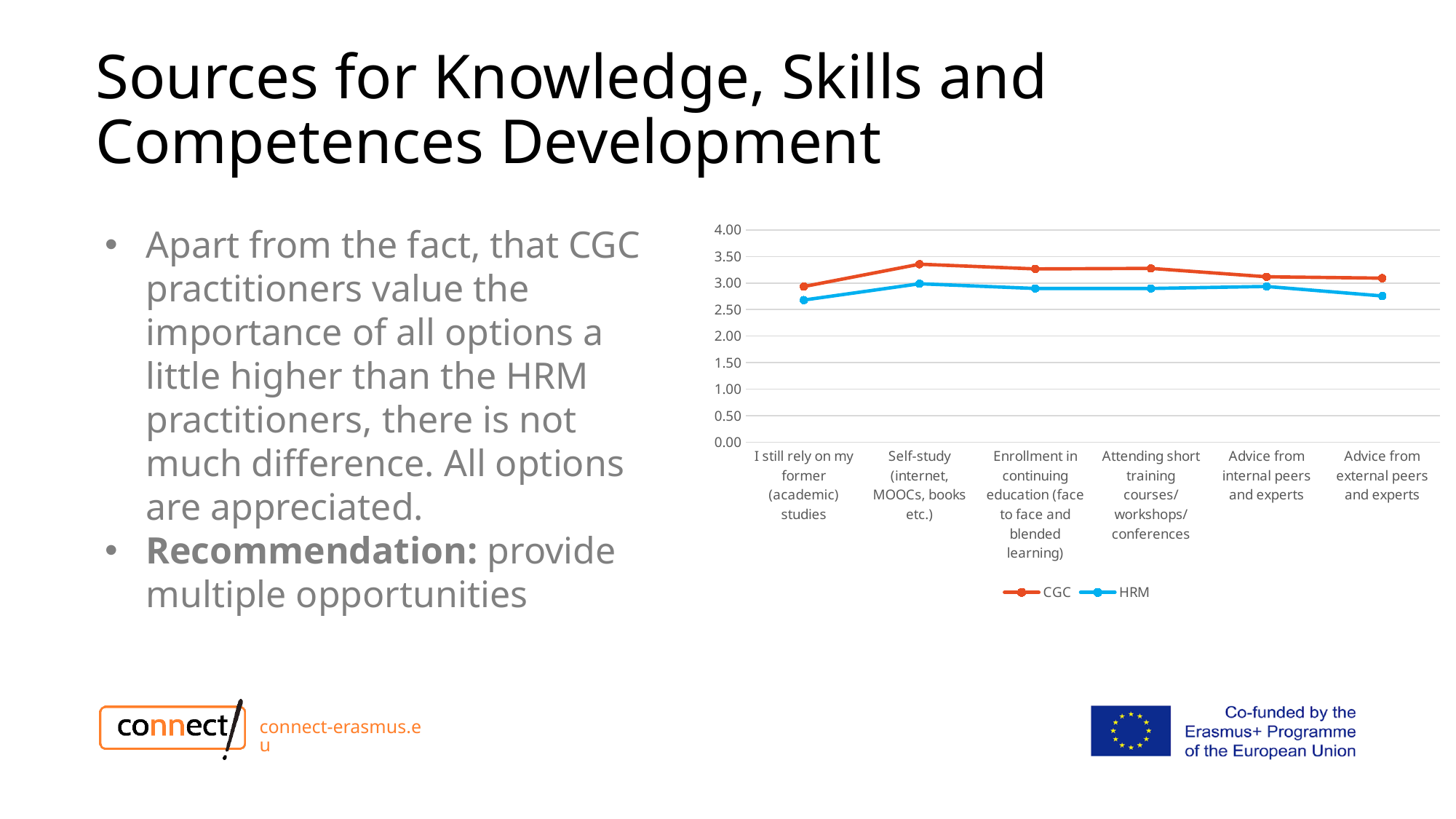
Is the CGC value for Self-study (internet, MOOCs, books etc.) greater or less than 3.00? greater Which series is drawn in blue in the chart? HRM How many series does the chart legend list? 2 Which category has the lowest value for the CGC series? I still rely on my former (academic) studies For Self-study (internet, MOOCs, books etc.), which series has the larger value, CGC or HRM? CGC For 'Attending short training courses/workshops/conferences', which series has the larger value, CGC or HRM? CGC Which category has the highest value for the CGC series? Self-study (internet, MOOCs, books etc.) Is the HRM value for 'Advice from external peers and experts' greater or less than 2.50? greater Is the HRM value for 'I still rely on my former (academic) studies' greater or less than 3.00? less What type of chart is shown on the slide? line chart How many categories are shown along the x axis of the chart? 6